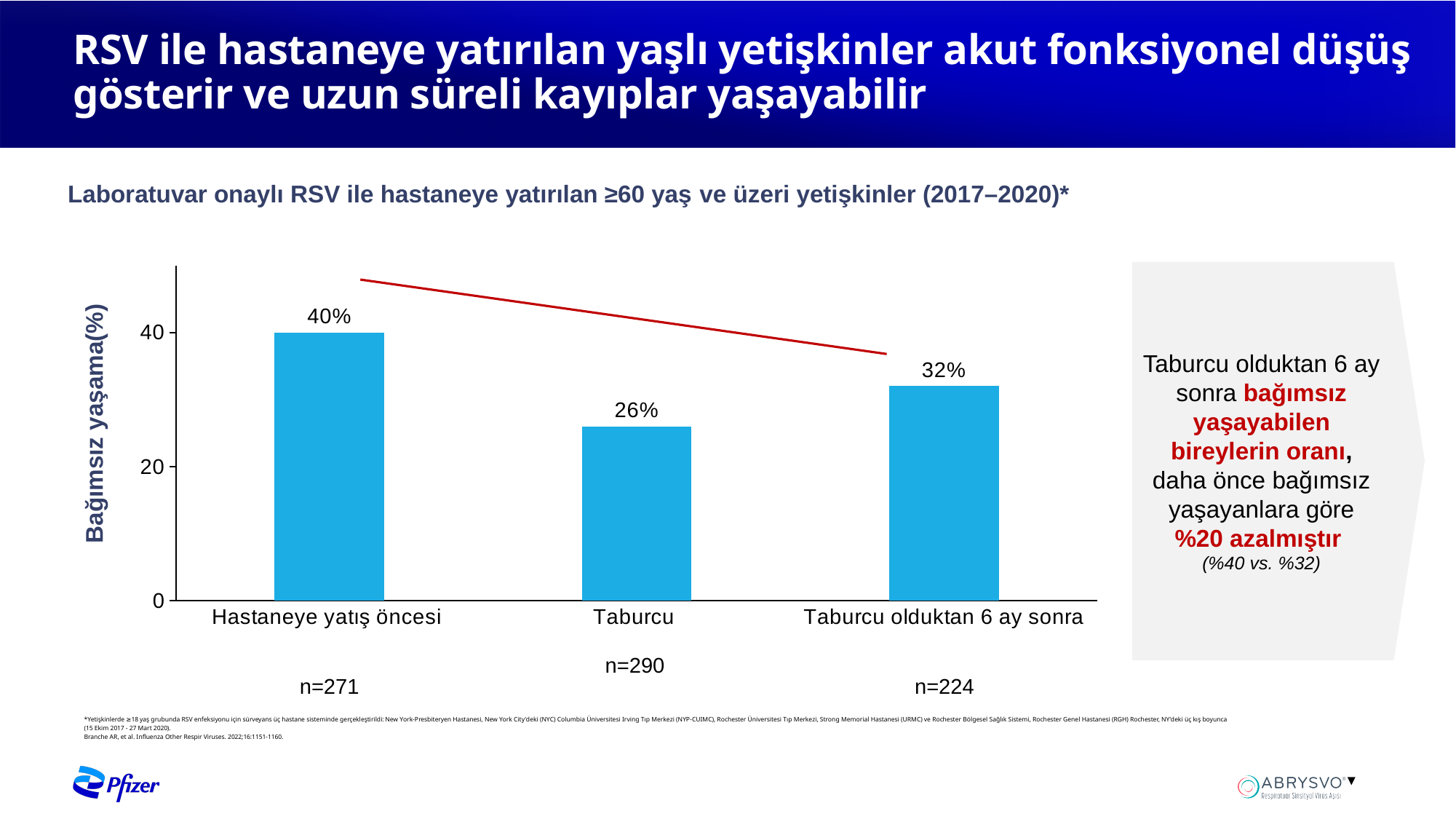
Is the value for "Taburcu" greater or less than 20? greater What is the value for "Hastaneye yatış öncesi"? 40% What is the value for "Taburcu olduktan 6 ay sonra"? 32% How many categories are shown on the x axis? 3 Which category has the highest value? Hastaneye yatış öncesi Which is larger, the value for "Taburcu" or the value for "Taburcu olduktan 6 ay sonra"? Taburcu olduktan 6 ay sonra Which category has the lowest value? Taburcu What kind of chart is shown on the slide? bar chart What is the value for "Taburcu"? 26% What is the label of the y axis? Bağımsız yaşama(%) What is the difference between the values for "Taburcu olduktan 6 ay sonra" and "Taburcu"? 6% What is the difference between the values for "Hastaneye yatış öncesi" and "Taburcu olduktan 6 ay sonra"? 8%